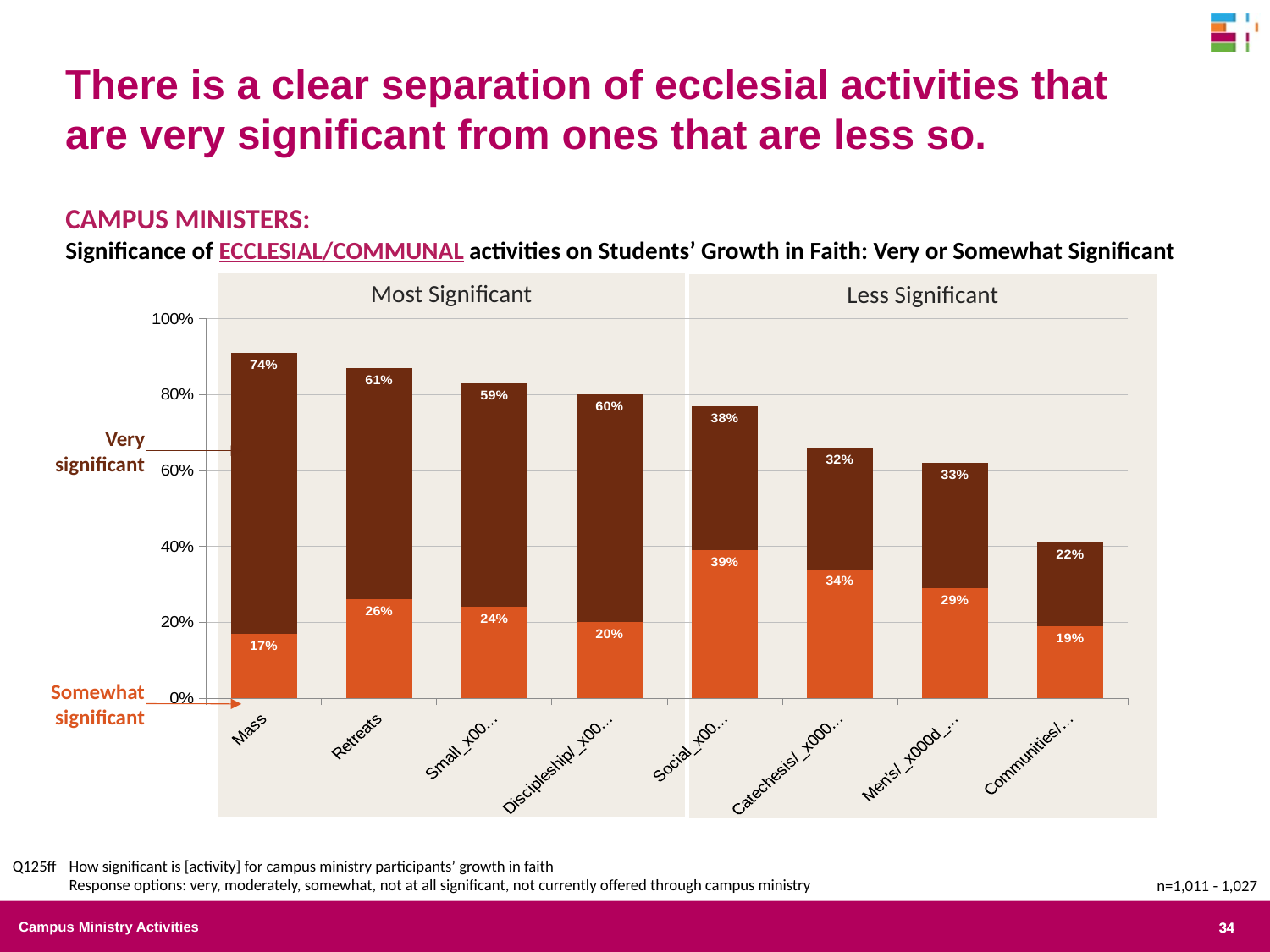
How many series are stacked in each bar? 2 Which activity has the highest 'Very significant' percentage? Mass How many activities (bars) are shown in the chart? 8 What is the 'Somewhat significant' value for Retreats? 26% What percentage of campus ministers rated Mass as very significant? 74% Which has a larger 'Somewhat significant' value, Mass or Retreats? Retreats What are the two group headings shown above the chart? Most Significant and Less Significant How many percentage points higher is the 'Very significant' value for Mass than for Retreats? 13 percentage points What is the combined (very plus somewhat significant) total for the Retreats bar? 87% What is the combined (very plus somewhat significant) total for the Mass bar? 91% What is the 'Very significant' value for Retreats? 61% What percentage of campus ministers rated Mass as somewhat significant? 17%